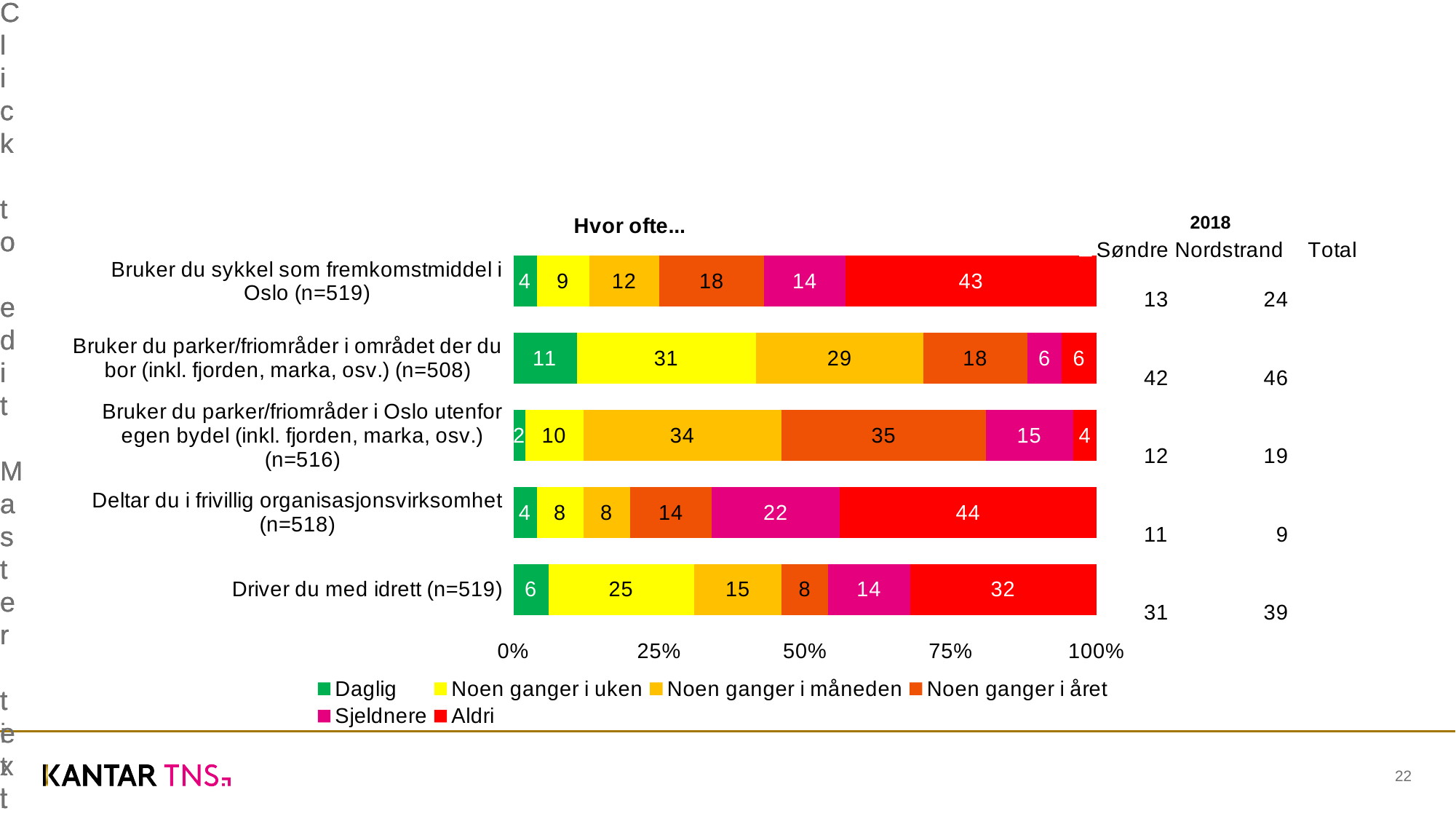
In the chart "Hvor ofte...", what is the "Daglig" value for "Bruker du parker/friområder i området der du bor (inkl. fjorden, marka, osv.) (n=508)"? 11 In the chart "Hvor ofte...", which category has the lowest "Daglig" value? Bruker du parker/friområder i Oslo utenfor egen bydel (inkl. fjorden, marka, osv.) (n=516) What is the title of the chart on the slide? Hvor ofte... How many categories (questions) are shown in the chart "Hvor ofte..."? 5 In the chart "Hvor ofte...", what is the value for "Noen ganger i uken" for "Driver du med idrett (n=519)"? 25 In the chart "Hvor ofte...", which category has the highest "Aldri" value? Deltar du i frivillig organisasjonsvirksomhet (n=518) In the chart "Hvor ofte...", what is the difference between the "Sjeldnere" value for "Deltar du i frivillig organisasjonsvirksomhet (n=518)" and the "Sjeldnere" value for "Bruker du sykkel som fremkomstmiddel i Oslo (n=519)"? 8 What kind of chart is "Hvor ofte..."? Stacked bar chart How many series does the legend of the chart "Hvor ofte..." list? 6 In the chart "Hvor ofte...", what is the value for "Aldri" for "Bruker du sykkel som fremkomstmiddel i Oslo (n=519)"? 43 In the chart "Hvor ofte...", what is the total of the stacked bar for "Bruker du sykkel som fremkomstmiddel i Oslo (n=519)"? 100 In the chart "Hvor ofte...", which has the larger "Noen ganger i måneden" value: "Bruker du parker/friområder i området der du bor" or "Bruker du parker/friområder i Oslo utenfor egen bydel"? Bruker du parker/friområder i Oslo utenfor egen bydel